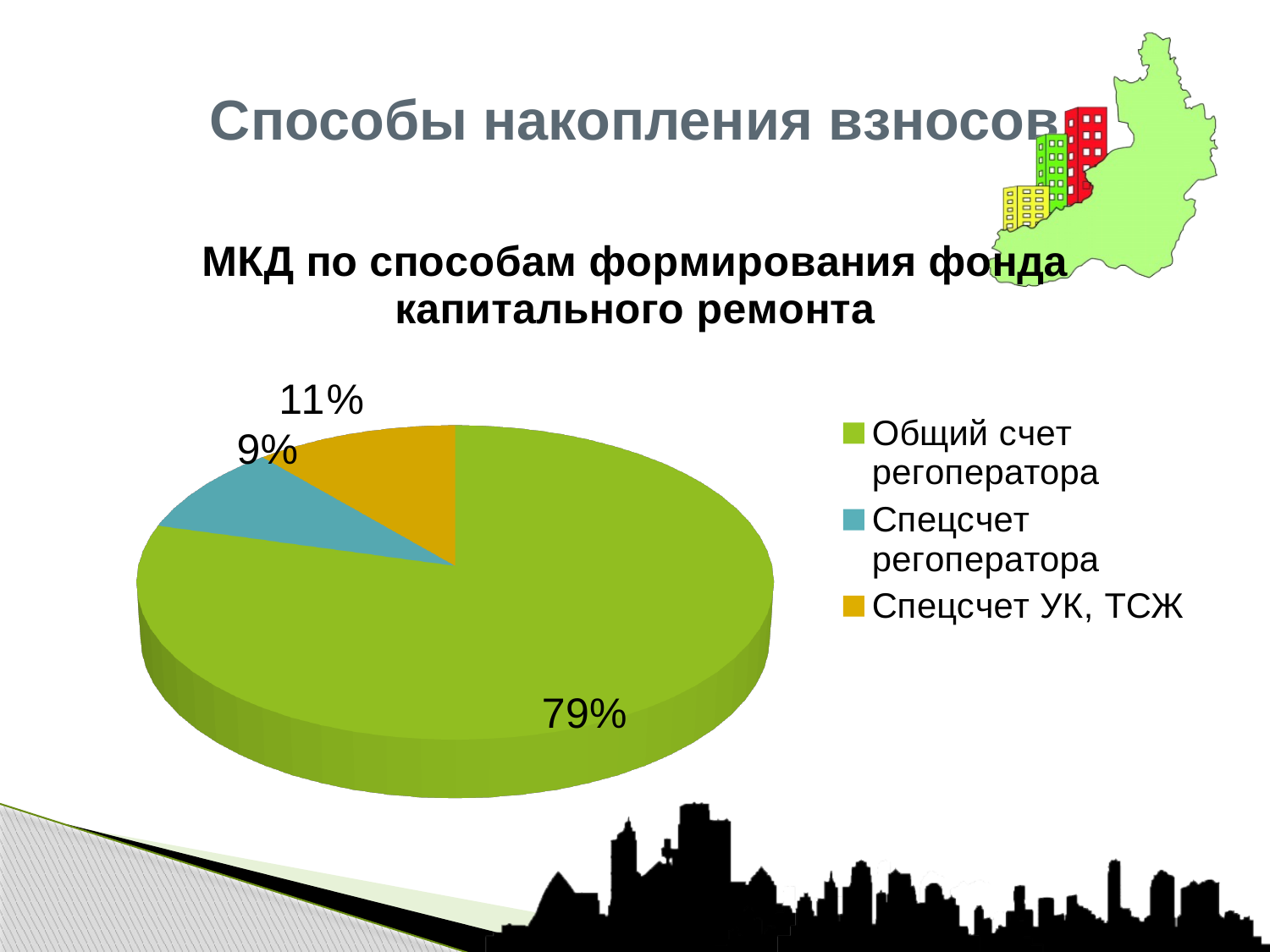
What type of chart is shown on the slide? Pie chart What share of the pie does "Спецсчет УК, ТСЖ" have? 11% What is the difference in percentage points between "Общий счет регоператора" and "Спецсчет УК, ТСЖ"? 68 Which is larger: the share for "Спецсчет УК, ТСЖ" or the share for "Спецсчет регоператора"? Спецсчет УК, ТСЖ What is the difference in percentage points between "Спецсчет УК, ТСЖ" and "Спецсчет регоператора"? 2 What is the title of the chart? МКД по способам формирования фонда капитального ремонта Which category has the largest slice of the pie? Общий счет регоператора How many slices does the pie chart have? 3 What share of the pie does "Общий счет регоператора" have? 79% What share of the pie does "Спецсчет регоператора" have? 9% Which colour represents "Спецсчет регоператора" in the legend? Blue Which category has the smallest slice of the pie? Спецсчет регоператора